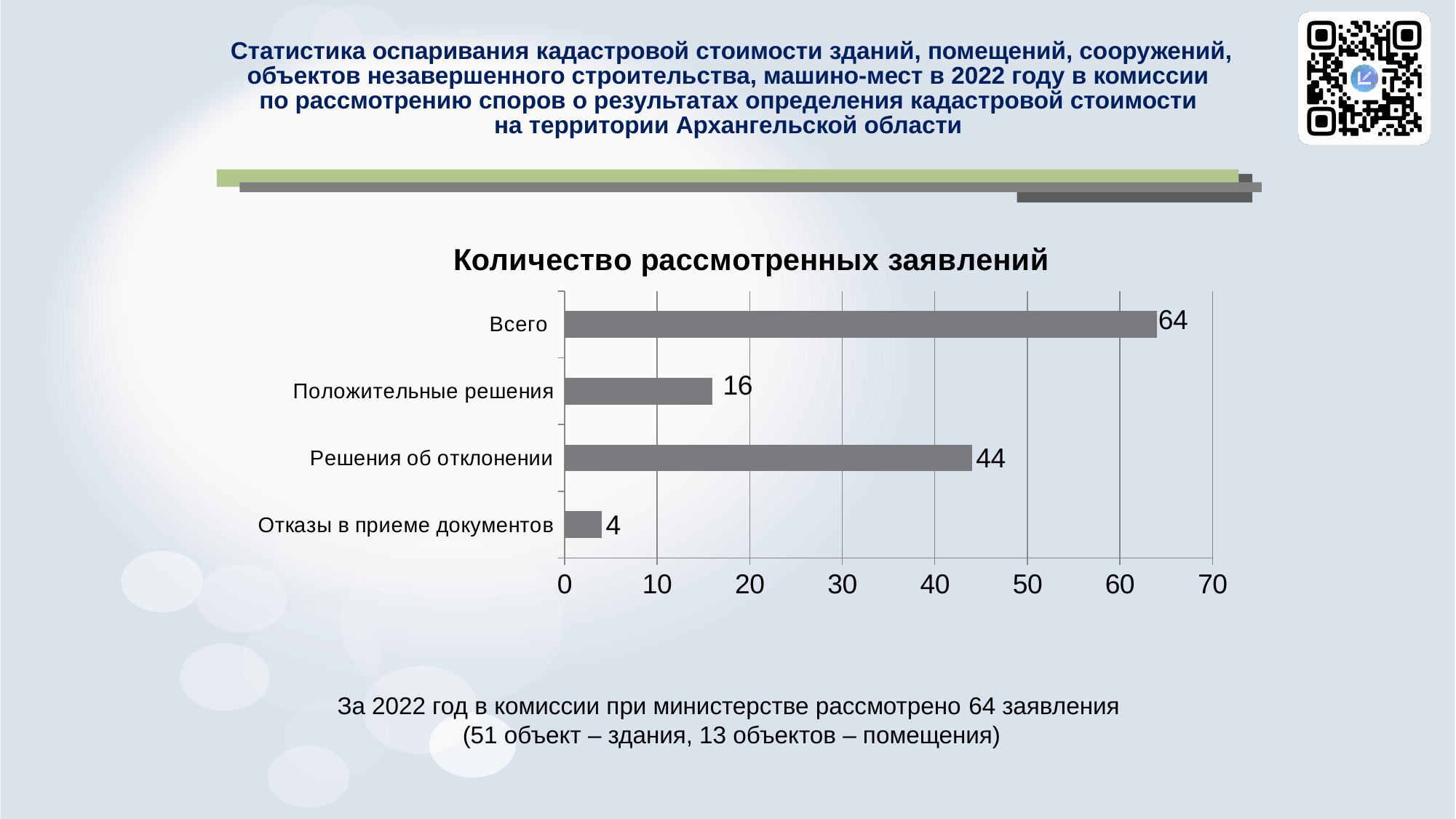
What is the value for Решения об отклонении? 44 Is the value for Решения об отклонении greater or less than 40? greater What is the value for Всего? 64 What kind of chart is shown? bar chart What is the difference between Решения об отклонении and Положительные решения? 28 Which is larger, Положительные решения or Решения об отклонении? Решения об отклонении Which category has the highest value? Всего What is the title of the chart? Количество рассмотренных заявлений What is the value for Положительные решения? 16 How many categories are shown in the chart? 4 Which category has the lowest value? Отказы в приеме документов What is the value for Отказы в приеме документов? 4